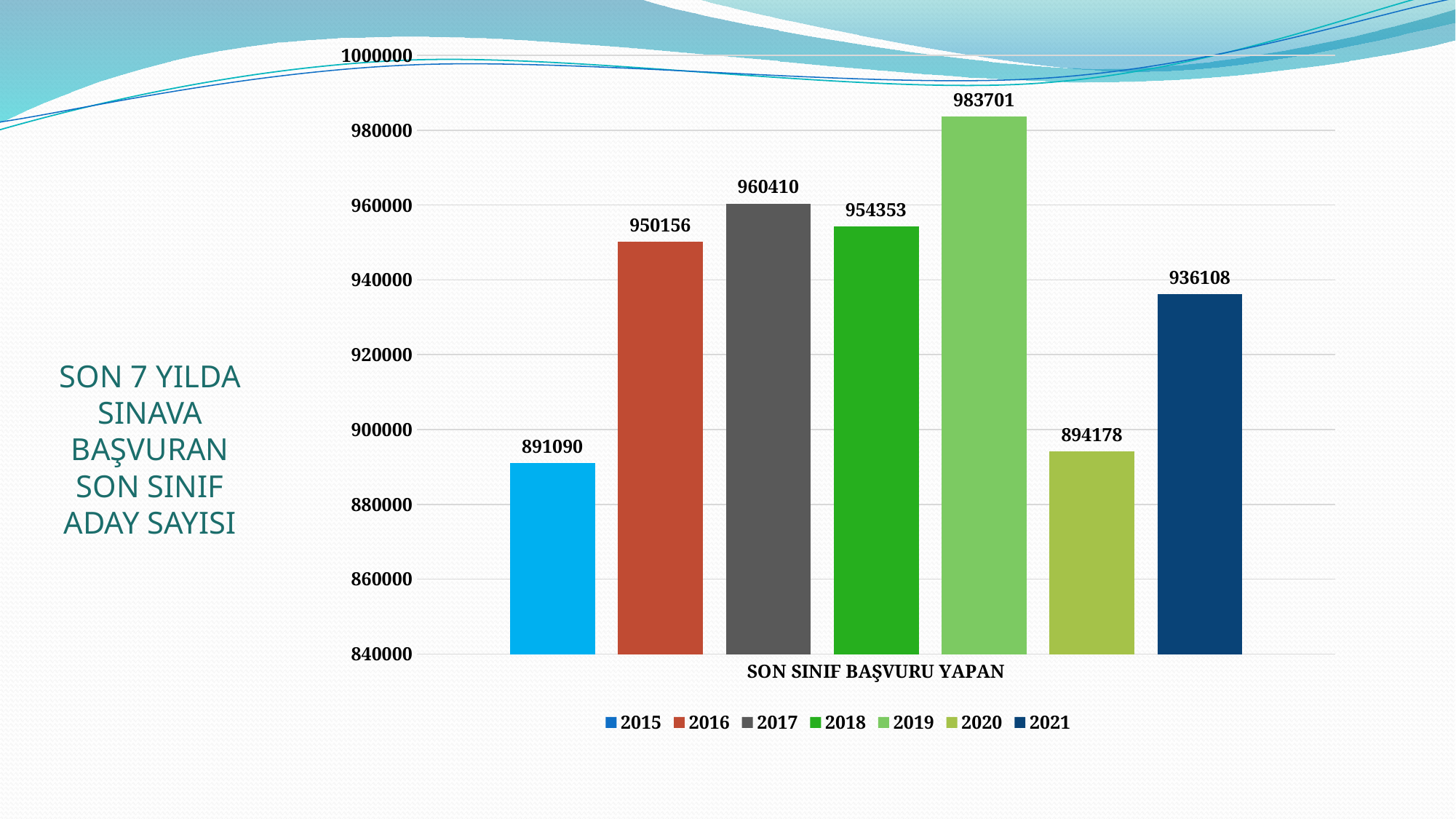
Which is larger, the value for 2017 or the value for 2018? 2017 How many bars are plotted in the chart? 7 What is the difference between the values for 2019 and 2015? 92611 What is the value for 2021 in the chart? 936108 How many series does the legend list? 7 What is the value for 2015 in the chart? 891090 What is the difference between the values for 2021 and 2020? 41930 What kind of chart is shown on the slide? bar chart What is the value for 2019 in the chart? 983701 Is the value for 2020 greater or less than 900000? less Which year has the lowest value in the chart? 2015 Which year has the highest value in the chart? 2019